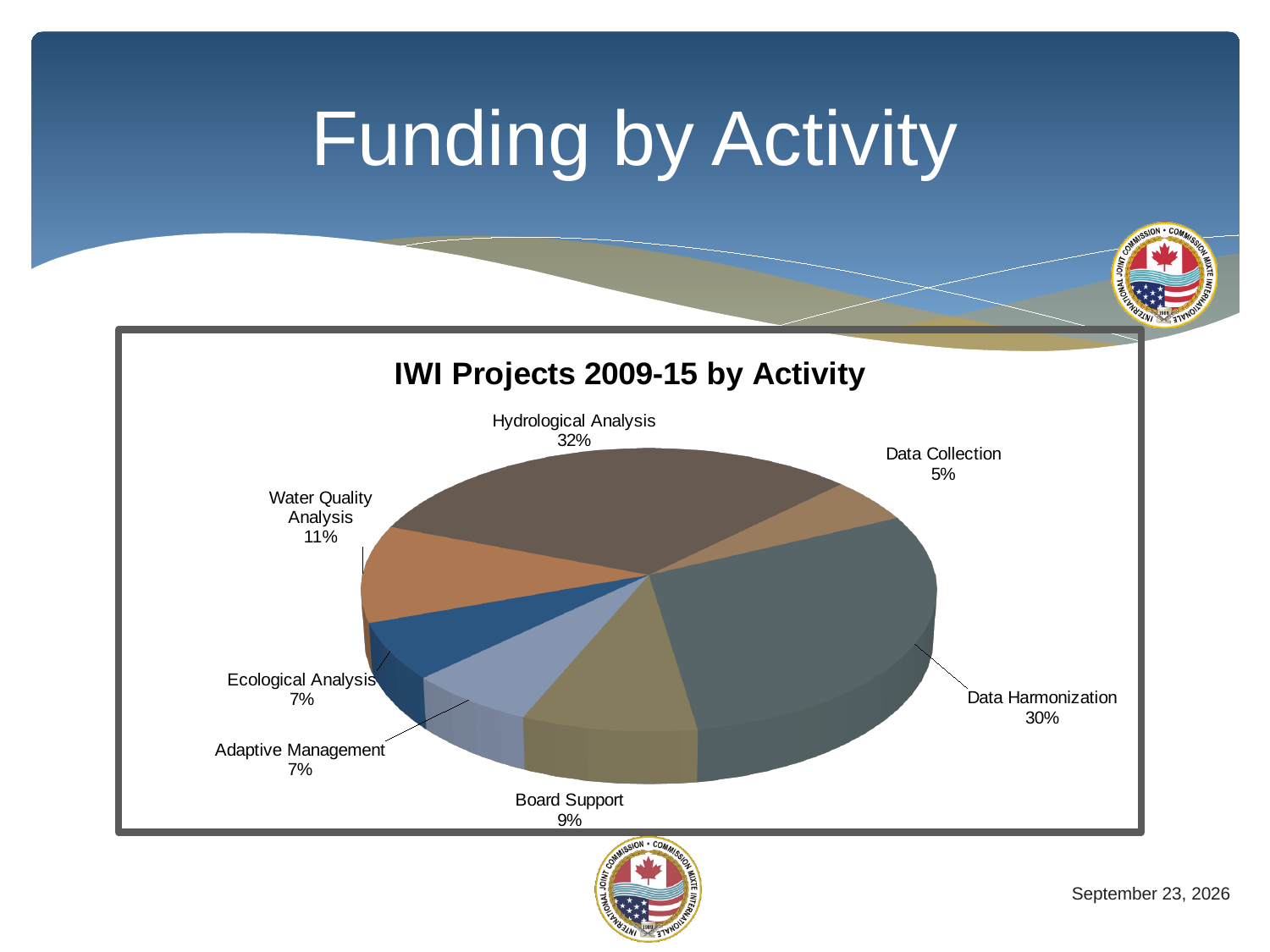
What share of the pie does Hydrological Analysis have? 32% What share of the pie does Data Harmonization have? 30% How many activity categories are shown in the pie chart? 7 What share of the pie does Water Quality Analysis have? 11% What is the difference in percentage points between Hydrological Analysis and Data Harmonization? 2 percentage points What is the title of the chart? IWI Projects 2009-15 by Activity Which activity has the smallest share of the pie? Data Collection What kind of chart is shown on the slide? Pie chart Which activity has the largest share of the pie? Hydrological Analysis Which has a larger share, Water Quality Analysis or Board Support? Water Quality Analysis